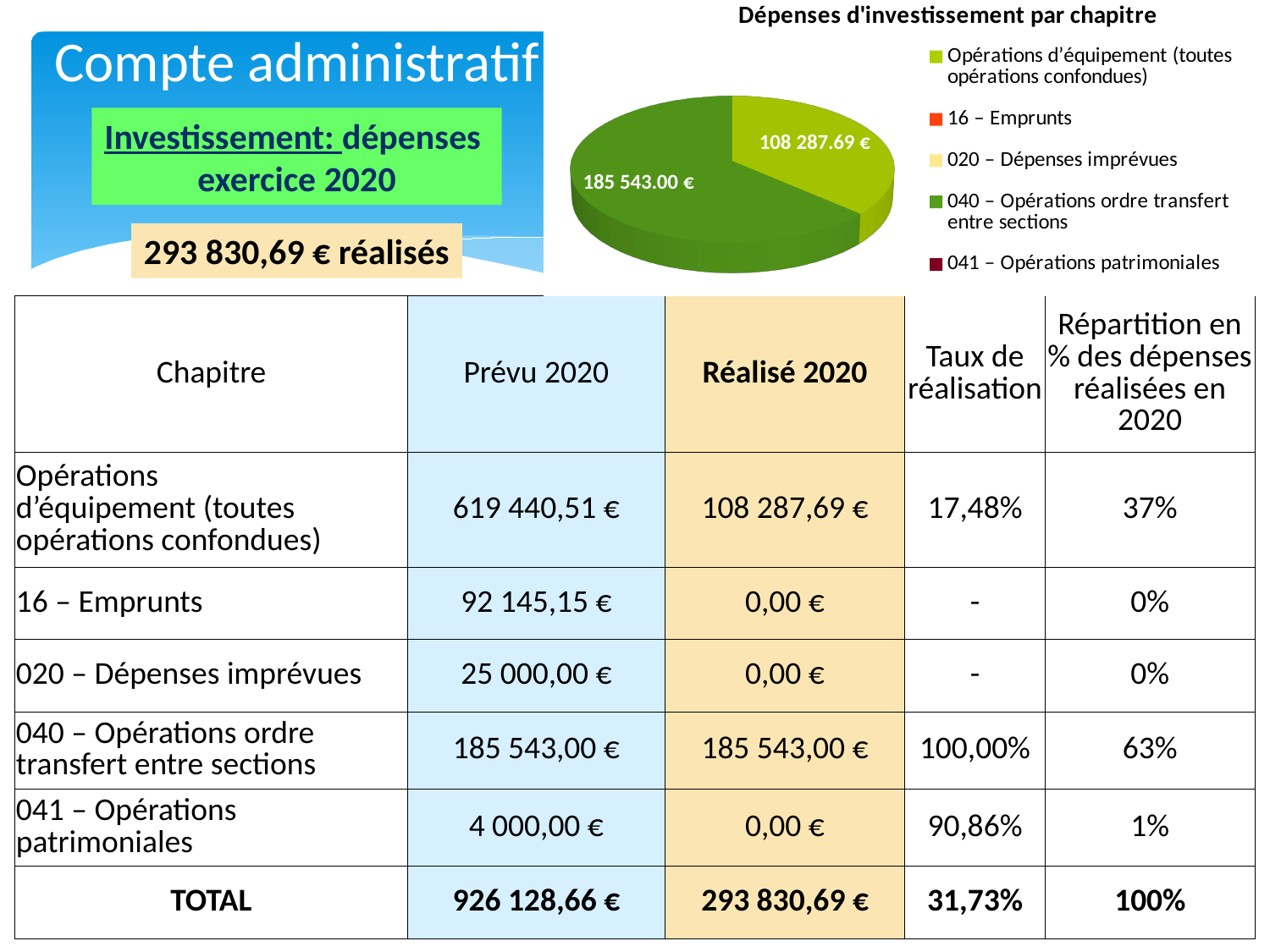
What is the difference between the two labelled slice values in the pie chart (185 543.00 € and 108 287.69 €)? 77 255.31 € What is the title of the pie chart? Dépenses d'investissement par chapitre Which of the two labelled slices in the pie chart is larger: Opérations d'équipement or 040 – Opérations ordre transfert entre sections? 040 – Opérations ordre transfert entre sections What share of the realised investment expenses does 040 – Opérations ordre transfert entre sections represent, according to the slide? 63% What is the total of the two labelled slices in the pie chart, as stated on the slide? 293 830,69 € In the pie chart, what value is shown for Opérations d'équipement (toutes opérations confondues)? 108 287.69 € What kind of chart is shown at the top of the slide? pie chart Which legend entry of the pie chart is shown in light green? Opérations d'équipement (toutes opérations confondues) How many entries does the legend of the pie chart list? 5 In the pie chart, what value is shown for 040 – Opérations ordre transfert entre sections? 185 543.00 € How many slices in the pie chart have a visible data label? 2 Which category has the largest slice in the pie chart? 040 – Opérations ordre transfert entre sections